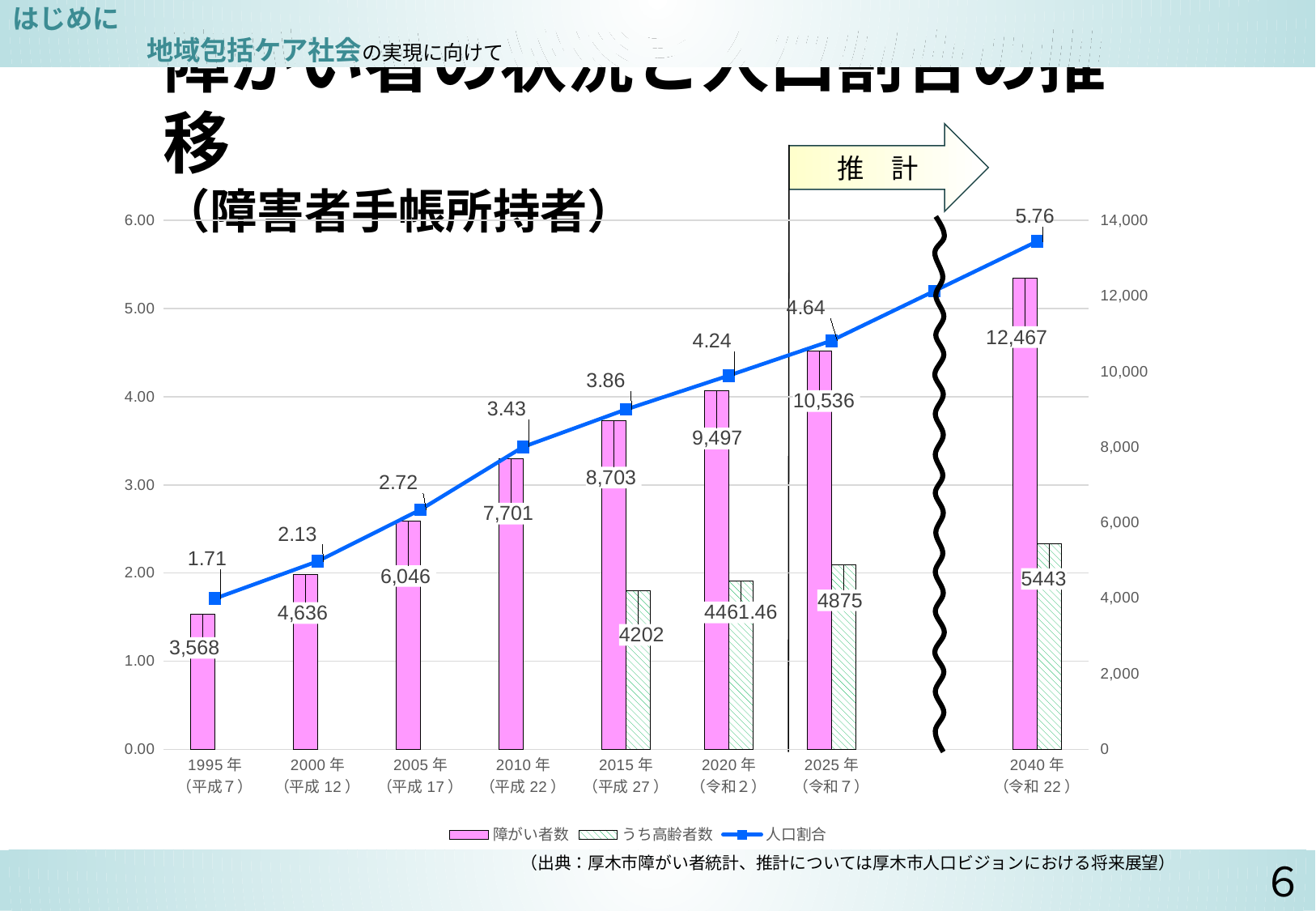
Is the 障がい者数 for 2005年（平成17） greater or less than 8,000? less What is the 人口割合 value for 2025年（令和7）? 4.64 Which is larger, the うち高齢者数 for 2015年（平成27） or for 2025年（令和7）? 2025年（令和7） What is the difference in 障がい者数 between 2040年（令和22） and 2025年（令和7）? 1,931 Which year has the lowest 人口割合? 1995年（平成7） What is the 障がい者数 value for 2010年（平成22）? 7,701 What kind of chart is shown on the slide? Combined bar and line chart Which year has the highest 障がい者数? 2040年（令和22） What is the うち高齢者数 value for 2020年（令和2）? 4461.46 Does the 人口割合 line rise or fall from 1995年 to 2040年? rise What is the difference in 人口割合 between 2020年（令和2） and 2015年（平成27）? 0.38 How many series does the legend list? 3